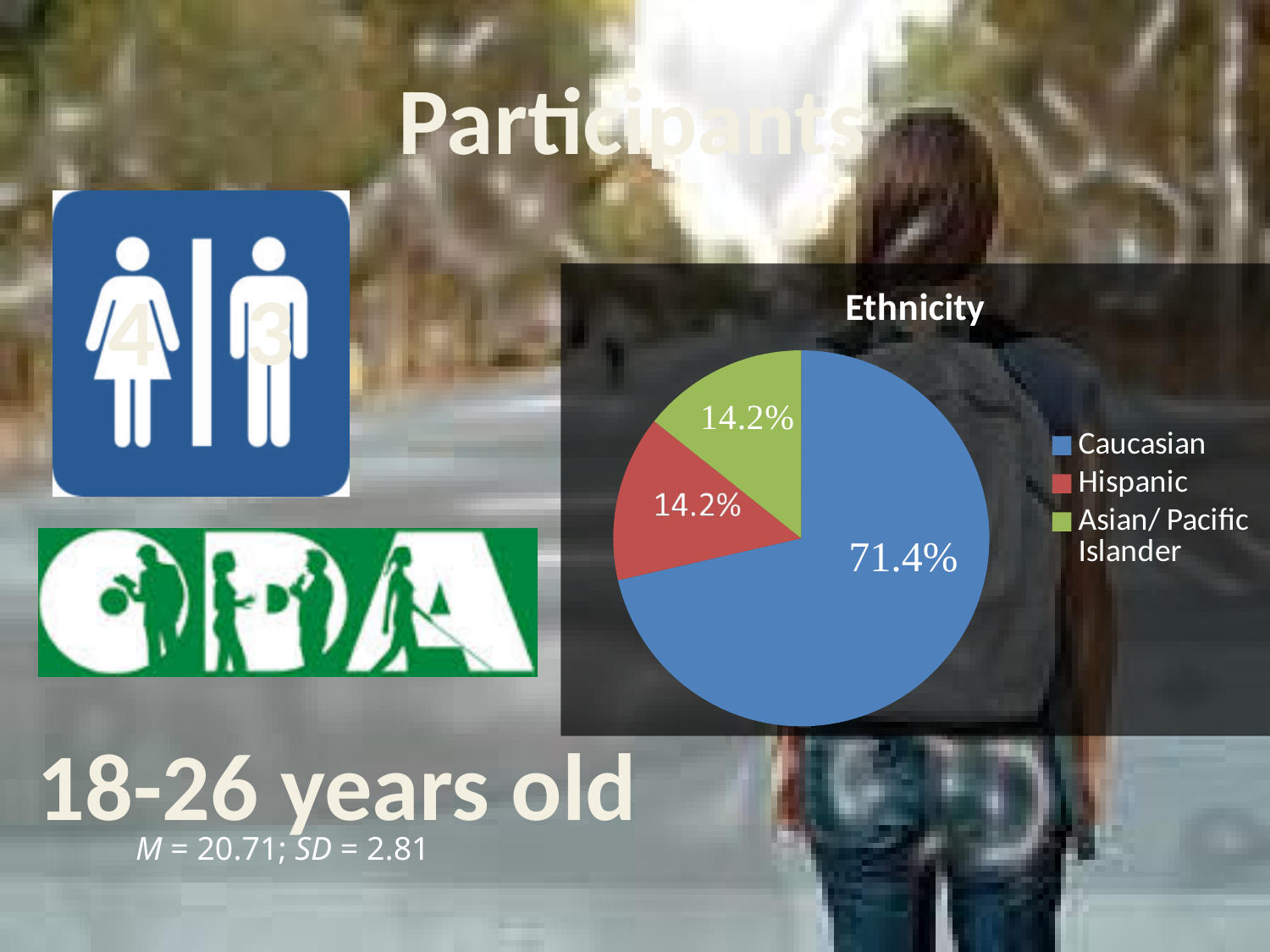
What percentage of the pie is Asian/ Pacific Islander? 14.2% Is the Caucasian share greater or less than 50%? greater What percentage of the pie is Caucasian? 71.4% What percentage of the pie is Hispanic? 14.2% What is the difference between the Caucasian share and the Hispanic share? 57.2% What colour represents Hispanic in the pie chart? red How many categories does the legend list? 3 What is the title of the chart? Ethnicity Which ethnicity has the largest share of the pie? Caucasian What type of chart is shown under the title "Ethnicity"? pie chart Which is larger, the Caucasian share or the Asian/ Pacific Islander share? Caucasian